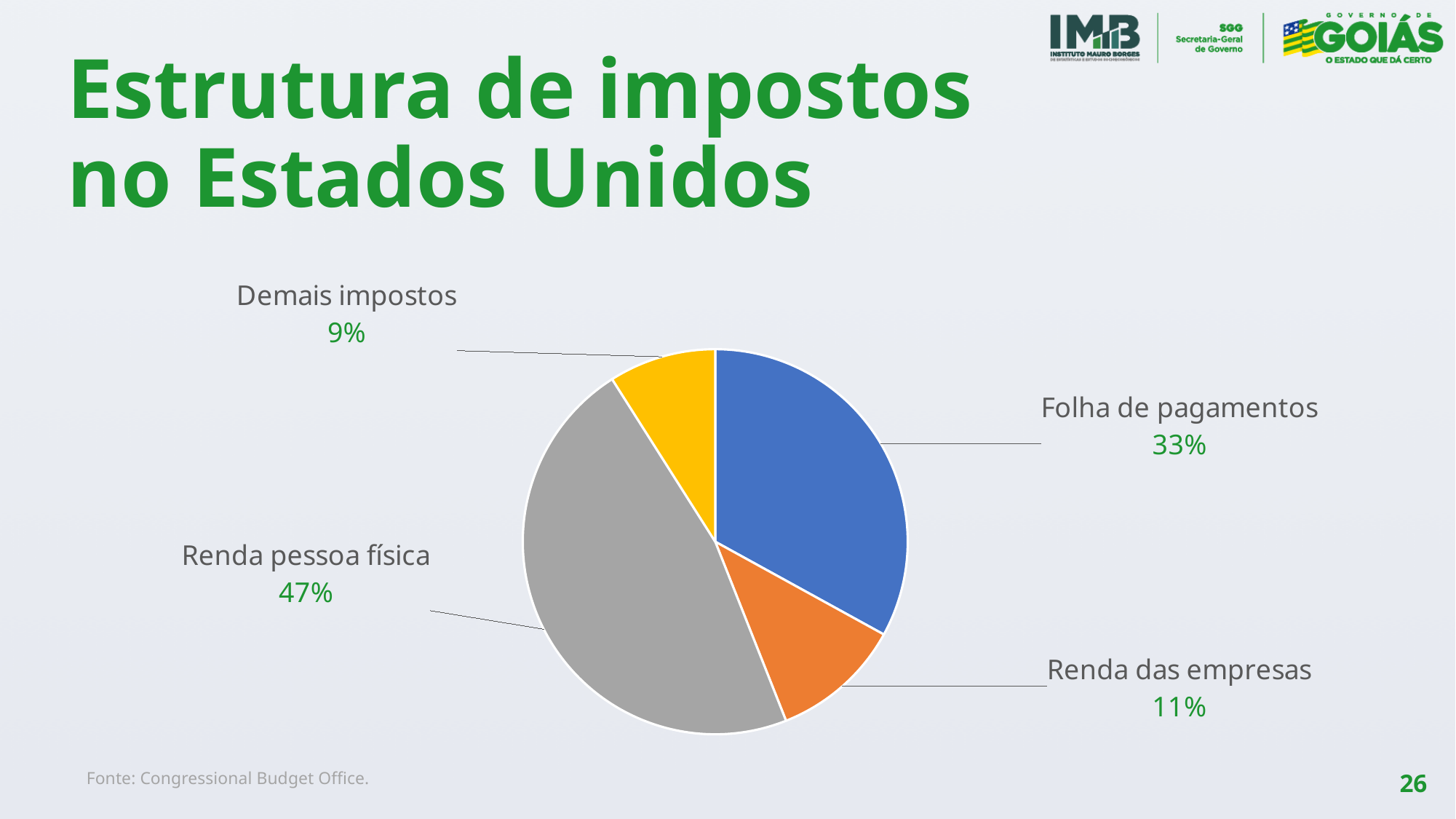
What is the difference between the shares of Renda pessoa física and Folha de pagamentos? 14 percentage points What is the value shown for Demais impostos? 9% Which is larger, the share for Renda das empresas or the share for Demais impostos? Renda das empresas What is the value shown for Renda pessoa física? 47% Which category has the smallest slice of the pie? Demais impostos What colour is the slice for Renda pessoa física? Grey What kind of chart is shown on the slide? Pie chart How many categories are shown in the pie chart? 4 What share of the pie does Folha de pagamentos represent? 33% What is the value shown for Renda das empresas? 11% Which category has the largest slice of the pie? Renda pessoa física What is the title of the slide containing the chart? Estrutura de impostos no Estados Unidos